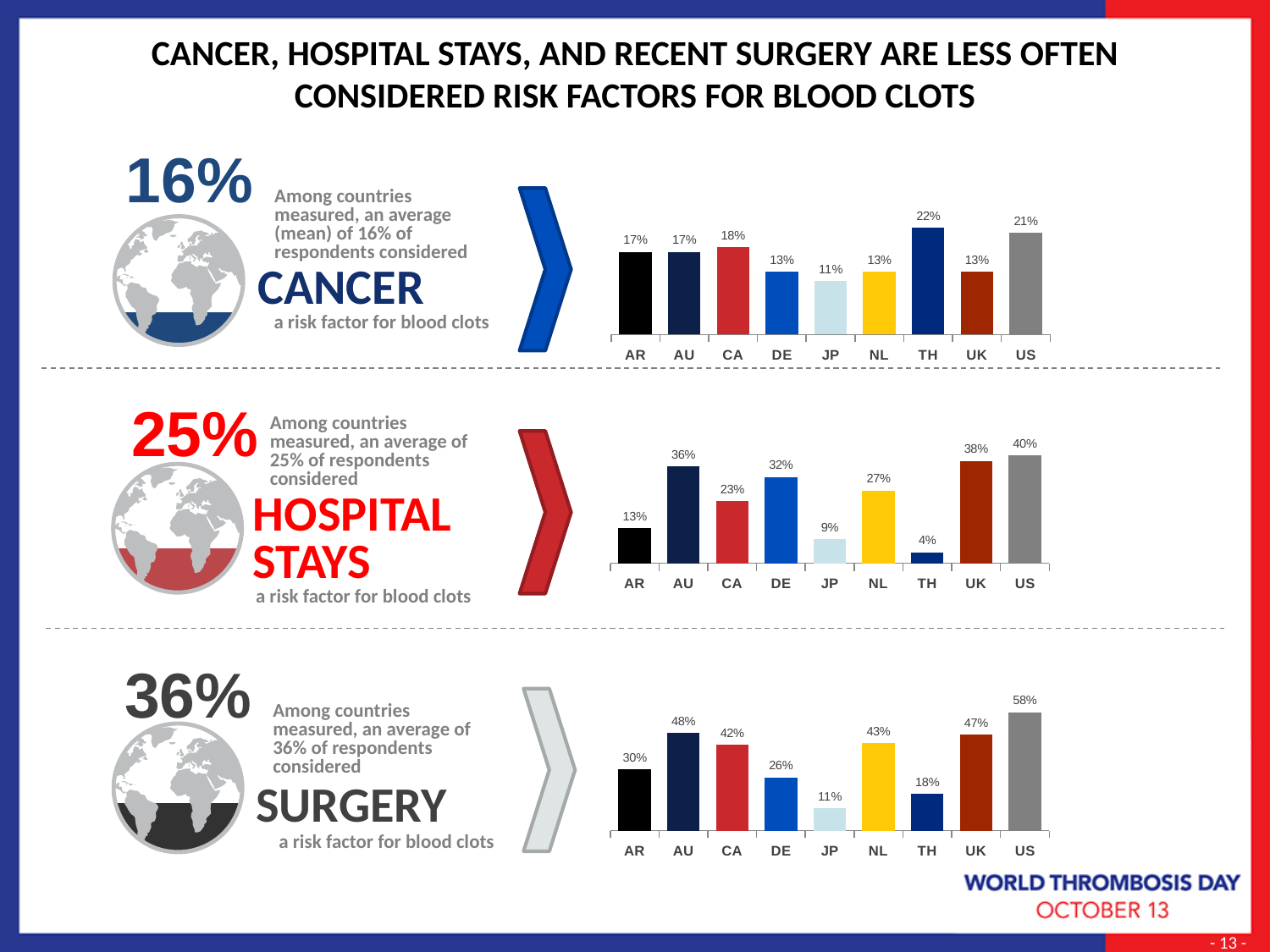
In the bottom chart (surgery as a risk factor), what is the difference between the values for AU and JP? 37% In the middle chart (hospital stays as a risk factor), what percentage is shown for NL? 27% In the top chart (cancer as a risk factor), which country has the lowest value? JP What type of chart is used to show the cancer risk factor data in the top chart? Bar chart In the bottom chart (surgery as a risk factor), which country has the highest value? US In the middle chart (hospital stays as a risk factor), which country has the lowest value? TH In the top chart (cancer as a risk factor), what percentage is shown for TH? 22% In the bottom chart (surgery as a risk factor), what percentage is shown for UK? 47% In the middle chart (hospital stays as a risk factor), which is larger, the value for AU or the value for DE? AU In the top chart (cancer as a risk factor), what is the difference between the values for US and DE? 8% In the middle chart (hospital stays as a risk factor), which country has the highest value? US How many countries are shown in the bottom chart (surgery as a risk factor)? 9